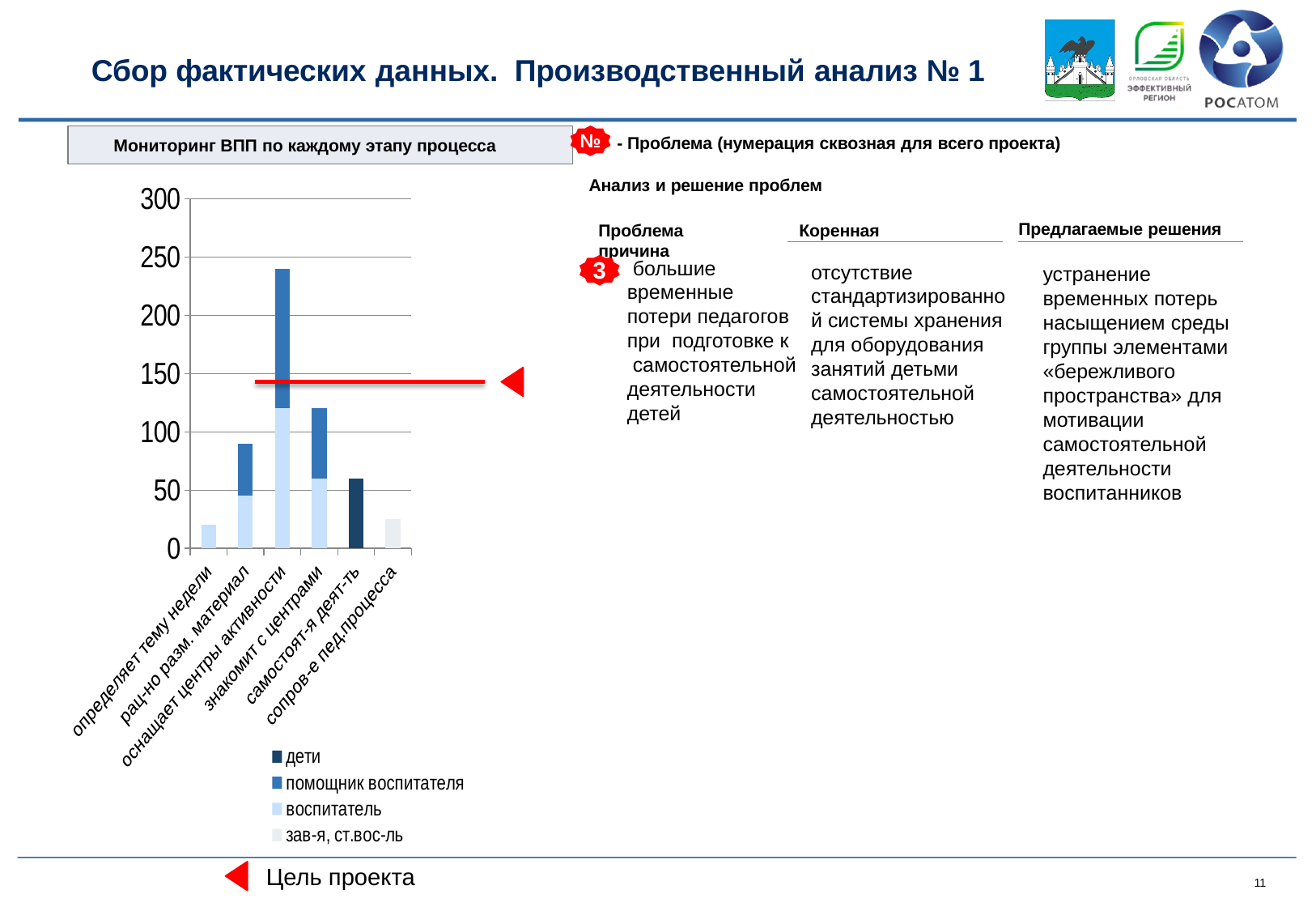
How many categories are shown on the x axis of the chart? 6 Is the total value for "оснащает центры активности" greater or less than 200? greater Is the total value for "знакомит с центрами" greater or less than 100? greater What kind of chart is shown on the slide? bar chart Which category has the tallest bar in the chart? оснащает центры активности Which bar is taller: "оснащает центры активности" or "знакомит с центрами"? оснащает центры активности Is the value for "определяет тему недели" greater or less than 50? less Which bar is taller: "рац-но разм. материал" or "сопров-е пед.процесса"? рац-но разм. материал Which series is listed first in the chart legend? дети What is the title shown above the chart? Мониторинг ВПП по каждому этапу процесса How many series does the chart legend list? 4